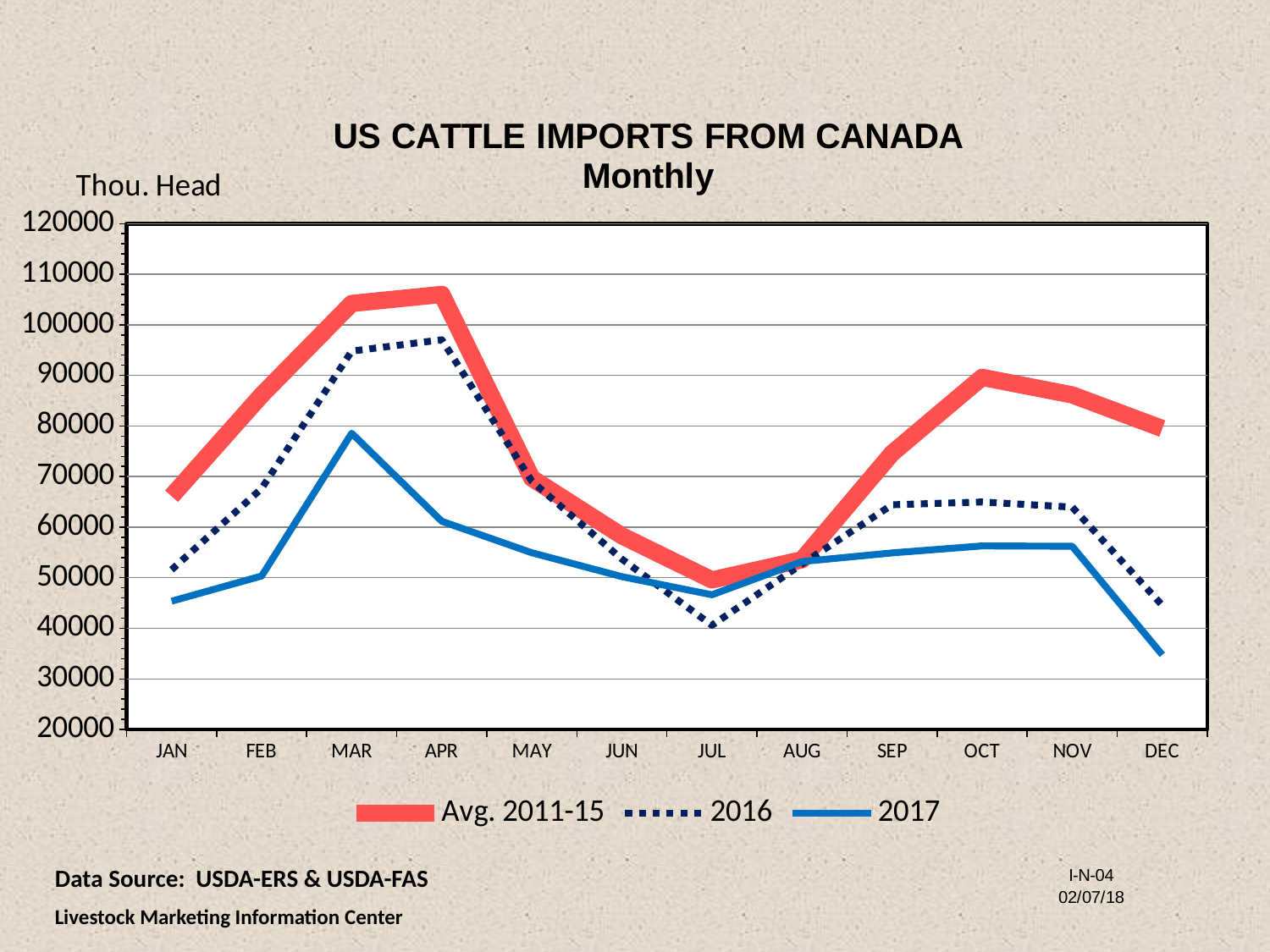
In which month does the 2016 series reach its lowest value? JUL In which month does the 2017 series reach its lowest value? DEC Is the 2017 value for MAR greater or less than 70000? greater In which month does the 2017 series reach its highest value? MAR Does the Avg. 2011-15 series rise or fall from APR to JUL? Fall How many series does the legend list? 3 Is the 2016 value for JUL greater or less than 50000? less How many months are plotted along the x axis? 12 In DEC, which series has the larger value, 2016 or 2017? 2016 Is the Avg. 2011-15 value for APR greater or less than 100000? greater What kind of chart is shown on the slide? Line chart In which month does the Avg. 2011-15 series reach its highest value? APR